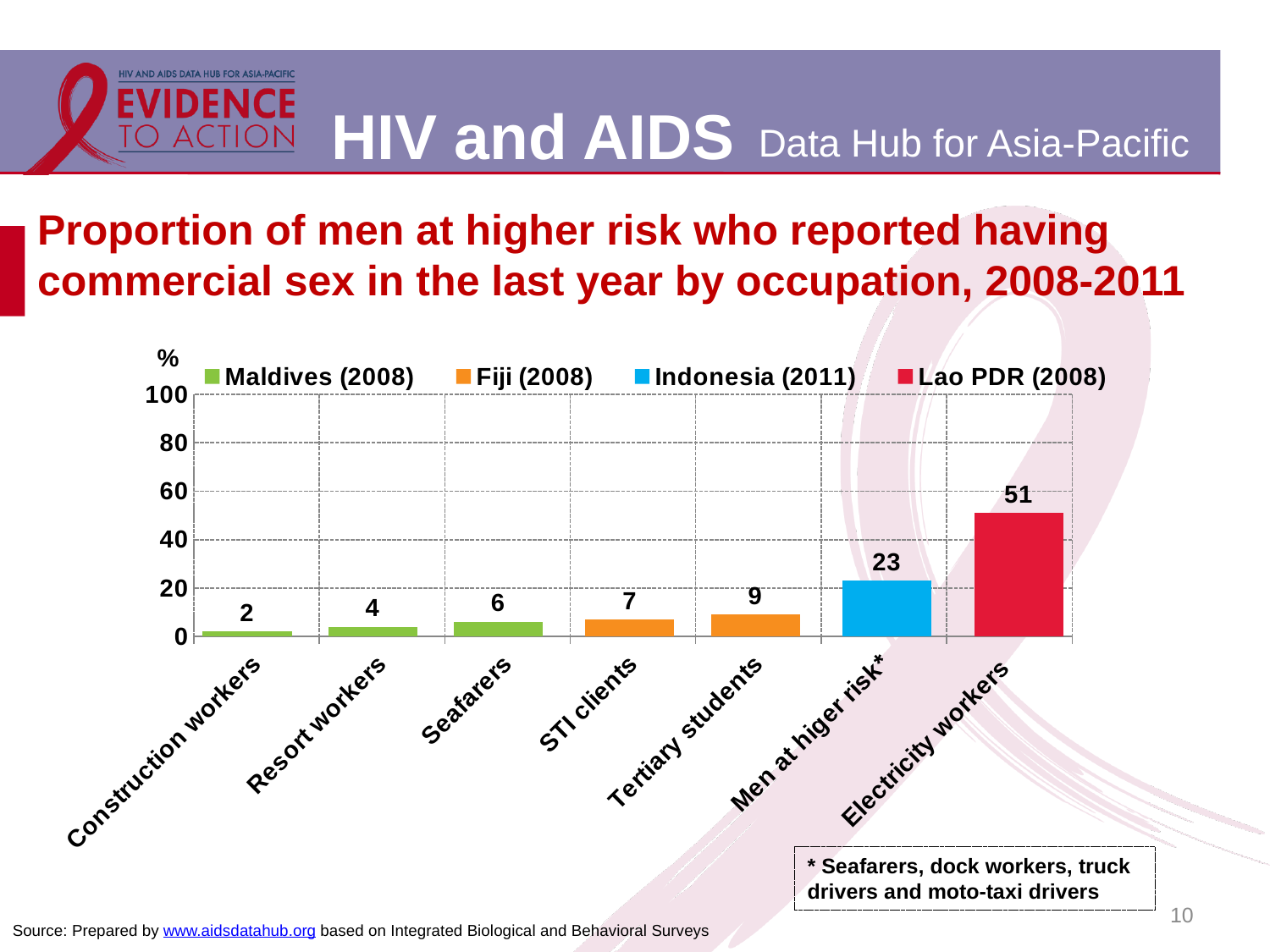
What is the value for Men at higher risk? 23 What kind of chart is shown? Bar chart What is the difference between the values for Electricity workers and Men at higher risk? 28 What is the value for Construction workers? 2 Which is larger, the value for Seafarers or the value for STI clients? STI clients Which occupation has the highest value? Electricity workers Is the value for Electricity workers greater or less than 40? greater What is the value for Tertiary students? 9 How many occupation categories are shown on the x axis? 7 Which occupation has the lowest value? Construction workers How many series does the legend list? 4 What is the value for Electricity workers? 51